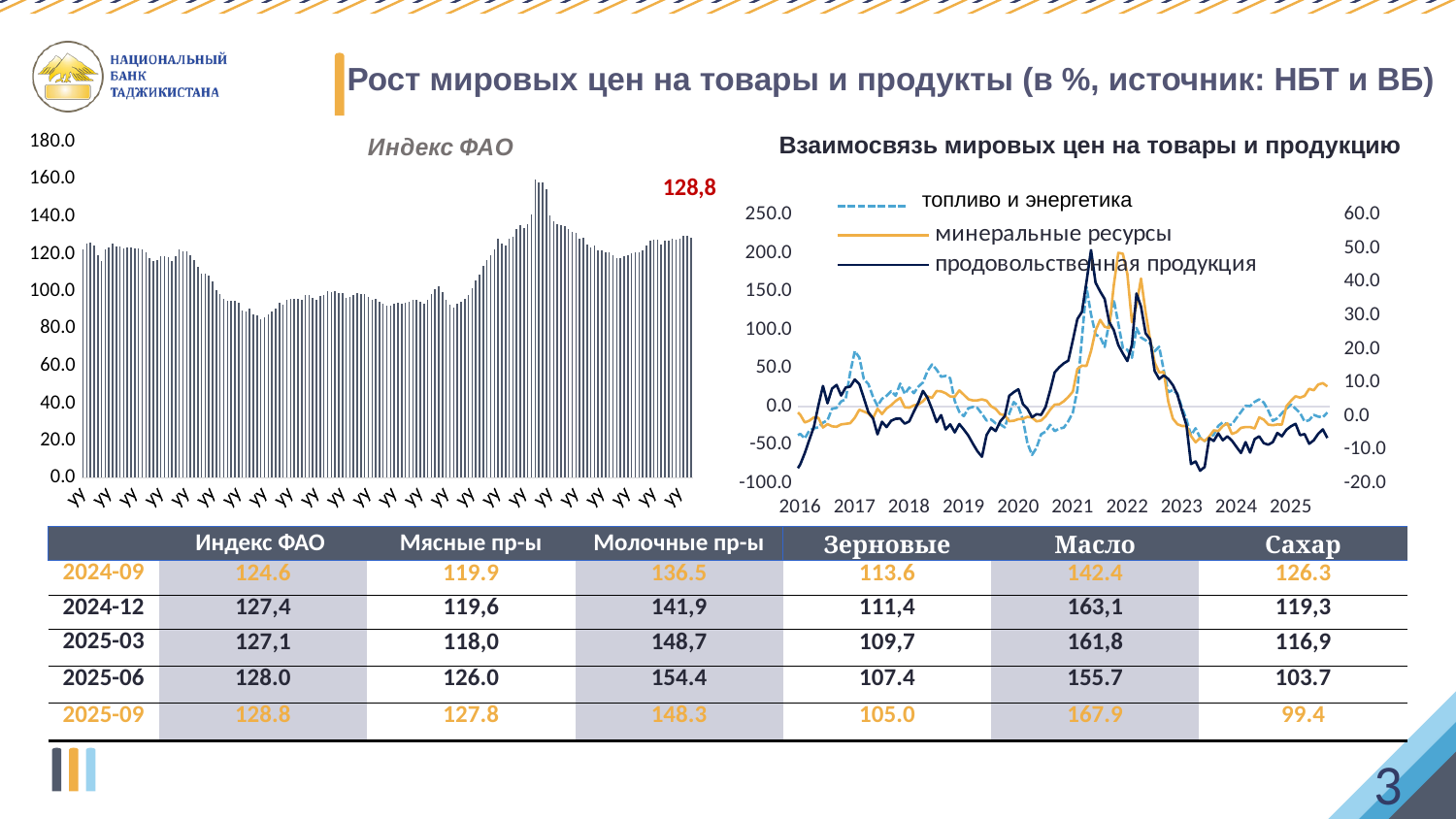
What kind of chart is the right chart titled "Взаимосвязь мировых цен на товары и продукцию"? line chart In the left chart "Индекс ФАО", what value is printed as the data label on the last bar? 128,8 In the left chart "Индекс ФАО", do the bars rise or fall from the tallest bar to the last bar? fall In the right chart "Взаимосвязь мировых цен на товары и продукцию", how many year labels are shown on the x axis? 10 In the left chart "Индекс ФАО", is the tallest bar greater or less than 140? greater In the right chart "Взаимосвязь мировых цен на товары и продукцию", which years are the first and last labels on the x axis? 2016 and 2025 In the left chart "Индекс ФАО", is the value of the last bar greater or less than 100? greater What kind of chart is the left chart titled "Индекс ФАО"? bar chart In the right chart "Взаимосвязь мировых цен на товары и продукцию", how many series does the legend list? 3 In the right chart "Взаимосвязь мировых цен на товары и продукцию", what are the three series named in the legend? топливо и энергетика, минеральные ресурсы, продовольственная продукция In the left chart "Индекс ФАО", what is the highest value shown on the y axis? 180.0